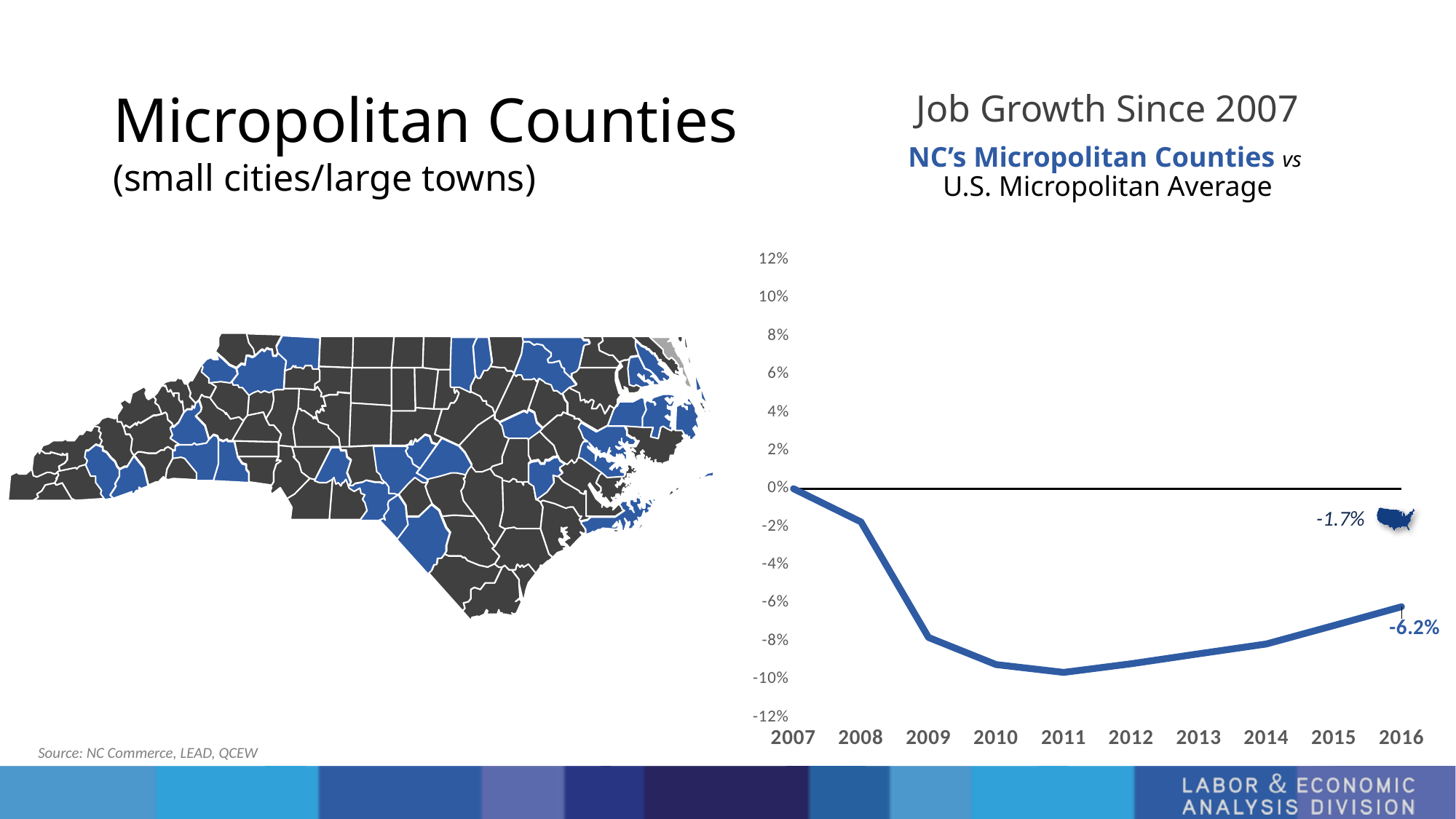
Is the value for NC's Micropolitan Counties in 2009 greater or less than -6%? less Is the value for NC's Micropolitan Counties in 2011 greater or less than -8%? less What is the title of the chart on the right side of the slide? Job Growth Since 2007 What is the job growth value for the U.S. Micropolitan Average in 2016? -1.7% What kind of chart is used to show job growth since 2007? Line chart What is the job growth value for NC's Micropolitan Counties in 2016? -6.2% How many years are shown on the x axis of the job growth chart? 10 Does the NC's Micropolitan Counties line rise or fall from 2011 to 2016? Rises Does the NC's Micropolitan Counties line rise or fall from 2007 to 2009? Falls In 2016, which is higher: NC's Micropolitan Counties or the U.S. Micropolitan Average? U.S. Micropolitan Average By how many percentage points does the U.S. Micropolitan Average exceed NC's Micropolitan Counties in 2016? 4.5 percentage points Is the value for NC's Micropolitan Counties in 2008 greater or less than -4%? greater